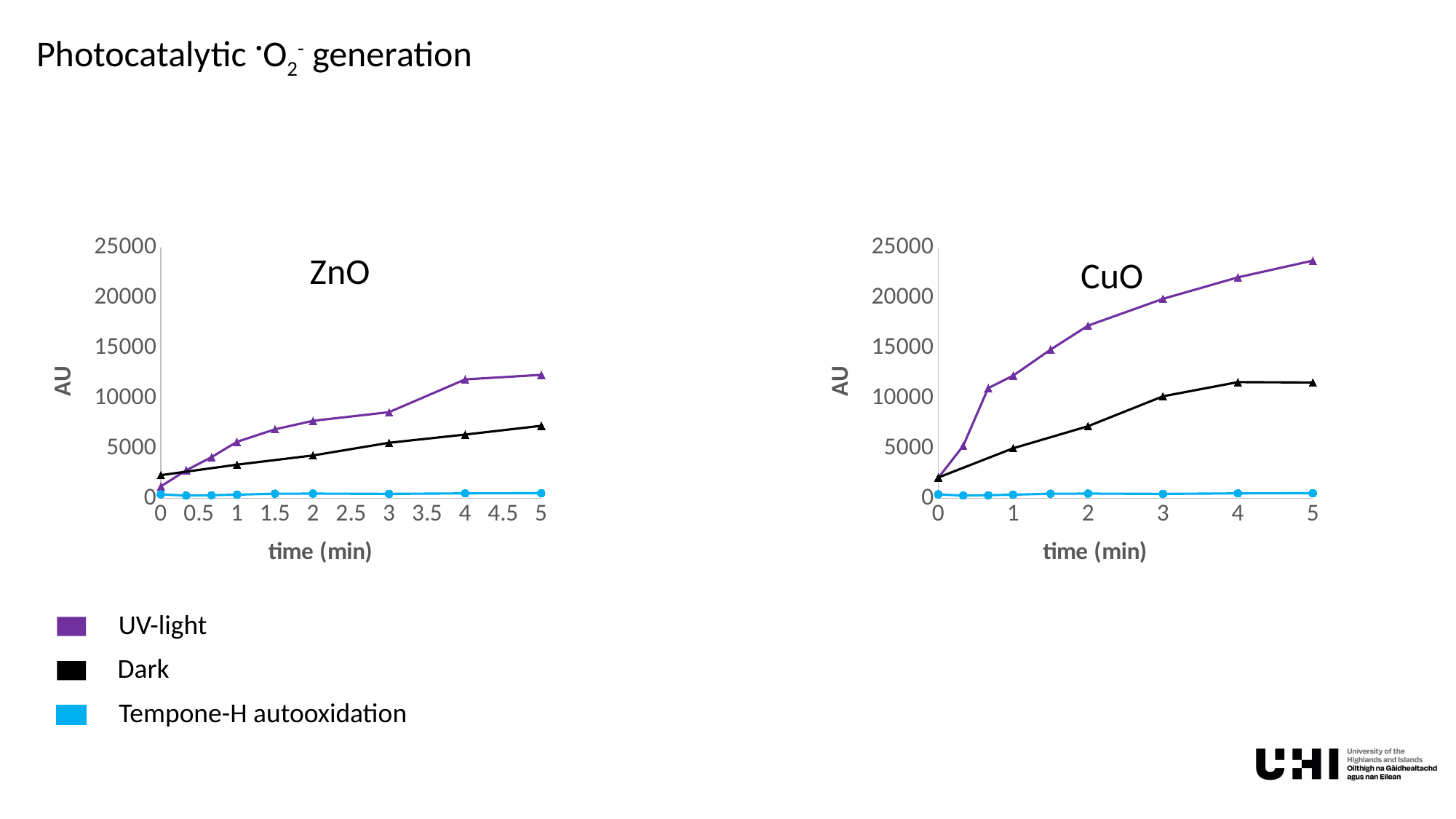
In the ZnO chart, is the Dark value at 5 min greater or less than 10000? less In the CuO chart, which series has the lowest values across the time range? Tempone-H autooxidation In the ZnO chart, which series has the highest value at 5 min? UV-light In the CuO chart, is the UV-light value at 5 min greater or less than 20000? greater In the CuO chart, is the UV-light value at 1 min greater or less than 10000? greater In the CuO chart, does the UV-light series rise or fall as time increases? rise What is the label on the y axis of both charts? AU What kind of chart is the ZnO chart? line chart How many series does the legend list? 3 At 5 min, is the UV-light value larger in the ZnO chart or the CuO chart? CuO